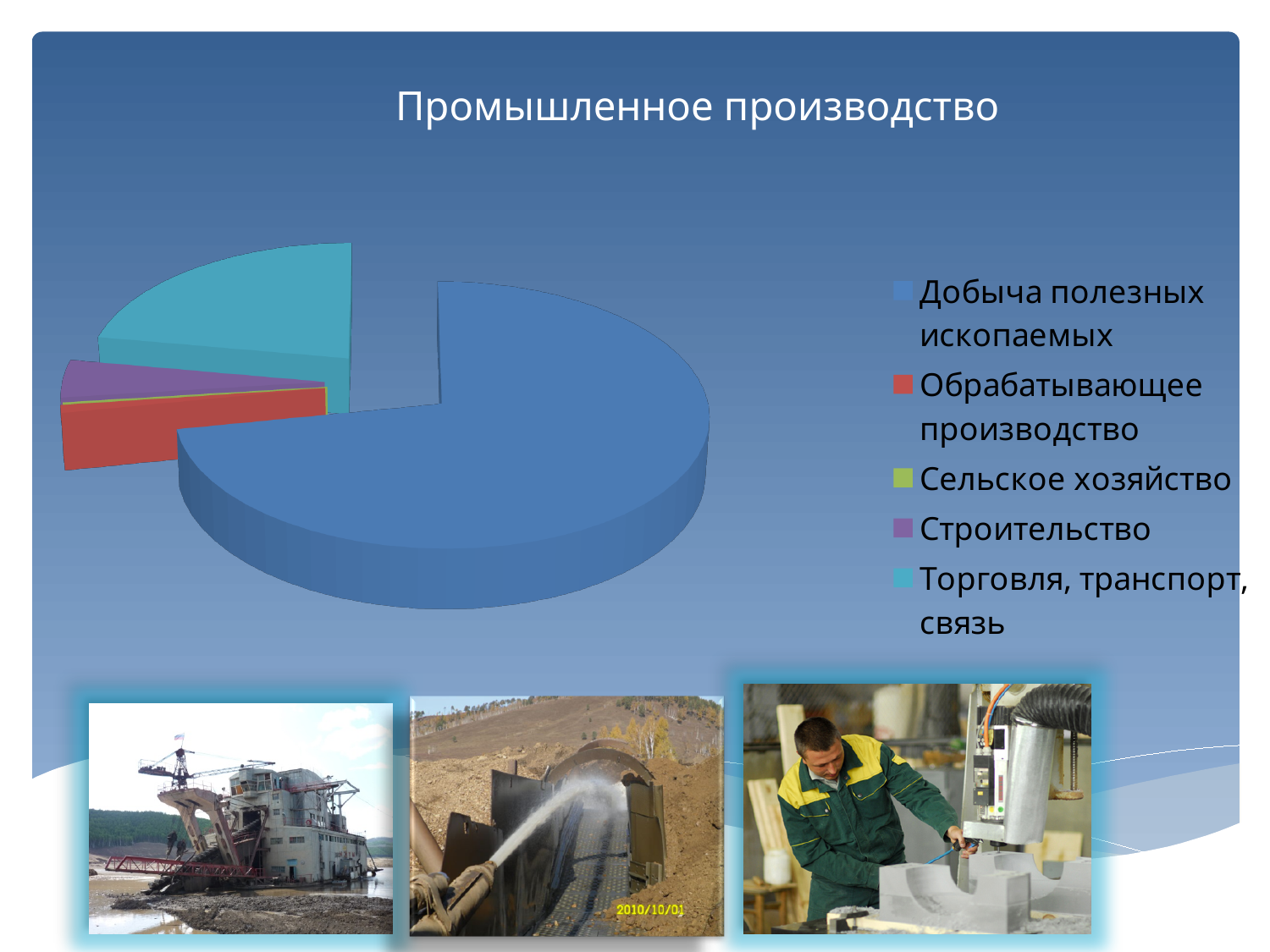
What is the title of the chart? Промышленное производство Which slice is larger: Строительство or Сельское хозяйство? Строительство Which slice is larger: Обрабатывающее производство or Строительство? Строительство Which slice is larger: Добыча полезных ископаемых or Торговля, транспорт, связь? Добыча полезных ископаемых What kind of chart is shown on the slide? pie chart Which category has the smallest slice of the pie? Сельское хозяйство Which category is the second-largest slice of the pie? Торговля, транспорт, связь What colour is the slice for Добыча полезных ископаемых? blue Which category has the largest slice of the pie? Добыча полезных ископаемых How many categories does the legend of the pie chart list? 5